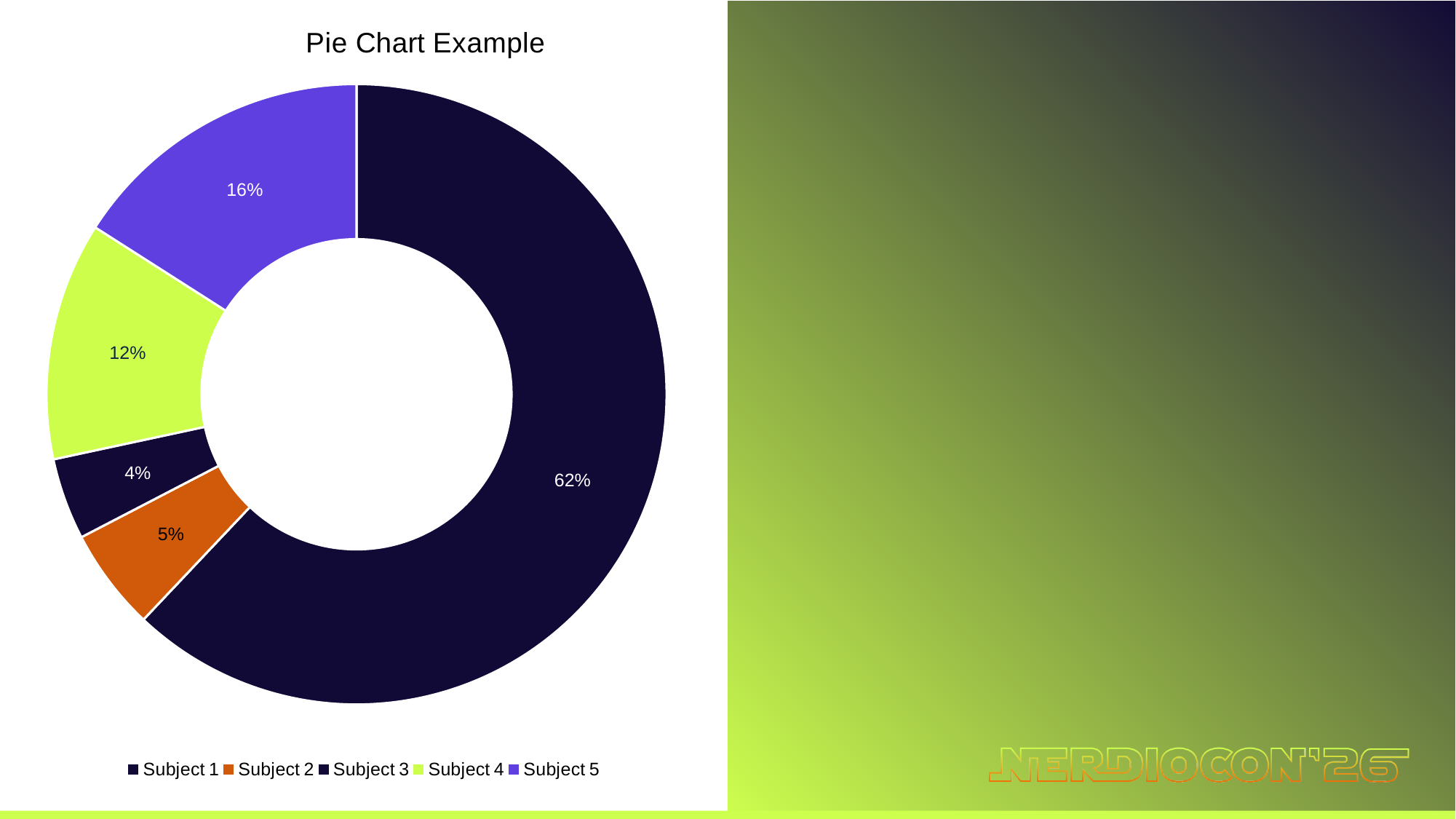
What kind of chart is shown on the slide? Doughnut chart What is the title of the chart? Pie Chart Example What percentage share does Subject 2 have? 5% What colour is the Subject 2 slice in the legend? Orange How many slices does the pie chart have? 5 What percentage share does Subject 5 have? 16% What is the difference in percentage points between Subject 5 and Subject 4? 4 Which has a larger share, Subject 4 or Subject 2? Subject 4 What percentage share does Subject 1 have? 62% Which subject has the largest share of the pie? Subject 1 Which subject has the smallest share of the pie? Subject 3